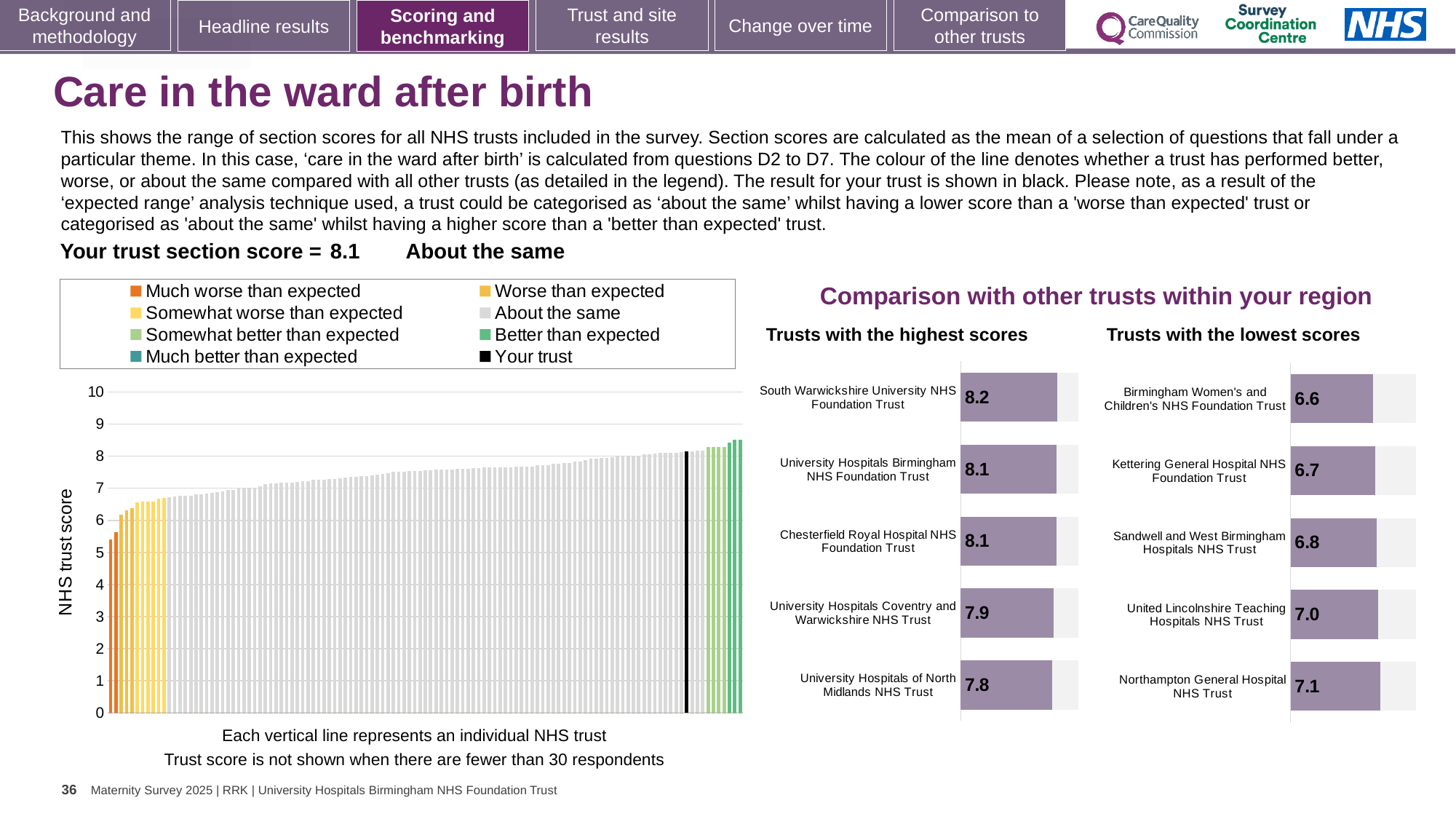
In the main NHS trust score chart on the left, what is the section score for your trust (the black bar)? 8.1 In the 'Trusts with the highest scores' chart, what is the score for South Warwickshire University NHS Foundation Trust? 8.2 In the 'Trusts with the lowest scores' chart, which trust has the lowest score? Birmingham Women's and Children's NHS Foundation Trust How many entries does the legend of the main NHS trust score chart list? 8 In the 'Trusts with the lowest scores' chart, which has the larger score: Sandwell and West Birmingham Hospitals NHS Trust or Northampton General Hospital NHS Trust? Northampton General Hospital NHS Trust In the 'Trusts with the lowest scores' chart, what is the score for Kettering General Hospital NHS Foundation Trust? 6.7 In the main NHS trust score chart on the left, do the bar values rise or fall from left to right? rise In the main NHS trust score chart on the left, is the value of the lowest (leftmost) bar greater or less than 6? less In the 'Trusts with the highest scores' chart, which trust has the highest score? South Warwickshire University NHS Foundation Trust How many trusts are listed in the 'Trusts with the lowest scores' chart? 5 In the 'Trusts with the highest scores' chart, what is the difference between the scores of South Warwickshire University NHS Foundation Trust and University Hospitals of North Midlands NHS Trust? 0.4 What kind of chart is the 'Trusts with the highest scores' chart? bar chart